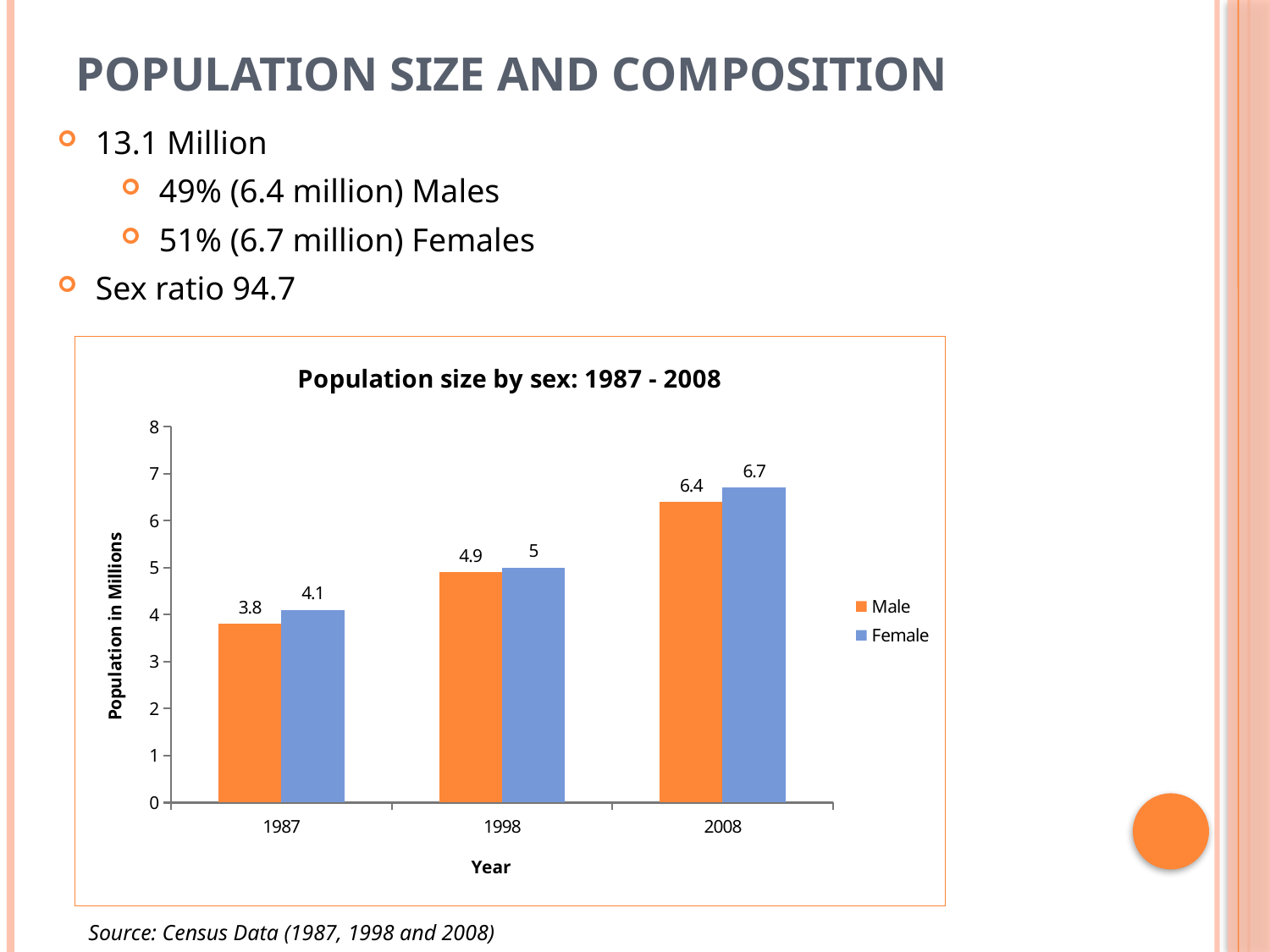
Is the Male value for 1998 greater or less than 4? greater What kind of chart is shown? Bar chart How many years are shown on the x axis? 3 What is the Male population in 1987? 3.8 What is the difference between the Female and Male populations in 2008? 0.3 What is the Female population in 2008? 6.7 How many series does the legend list? 2 What is the Female population in 1998? 5 In which year is the Female population lowest? 1987 In which year is the Male population highest? 2008 Which is larger in 1998, the Male or the Female population? Female Does the Male population rise or fall from 1987 to 2008? Rise